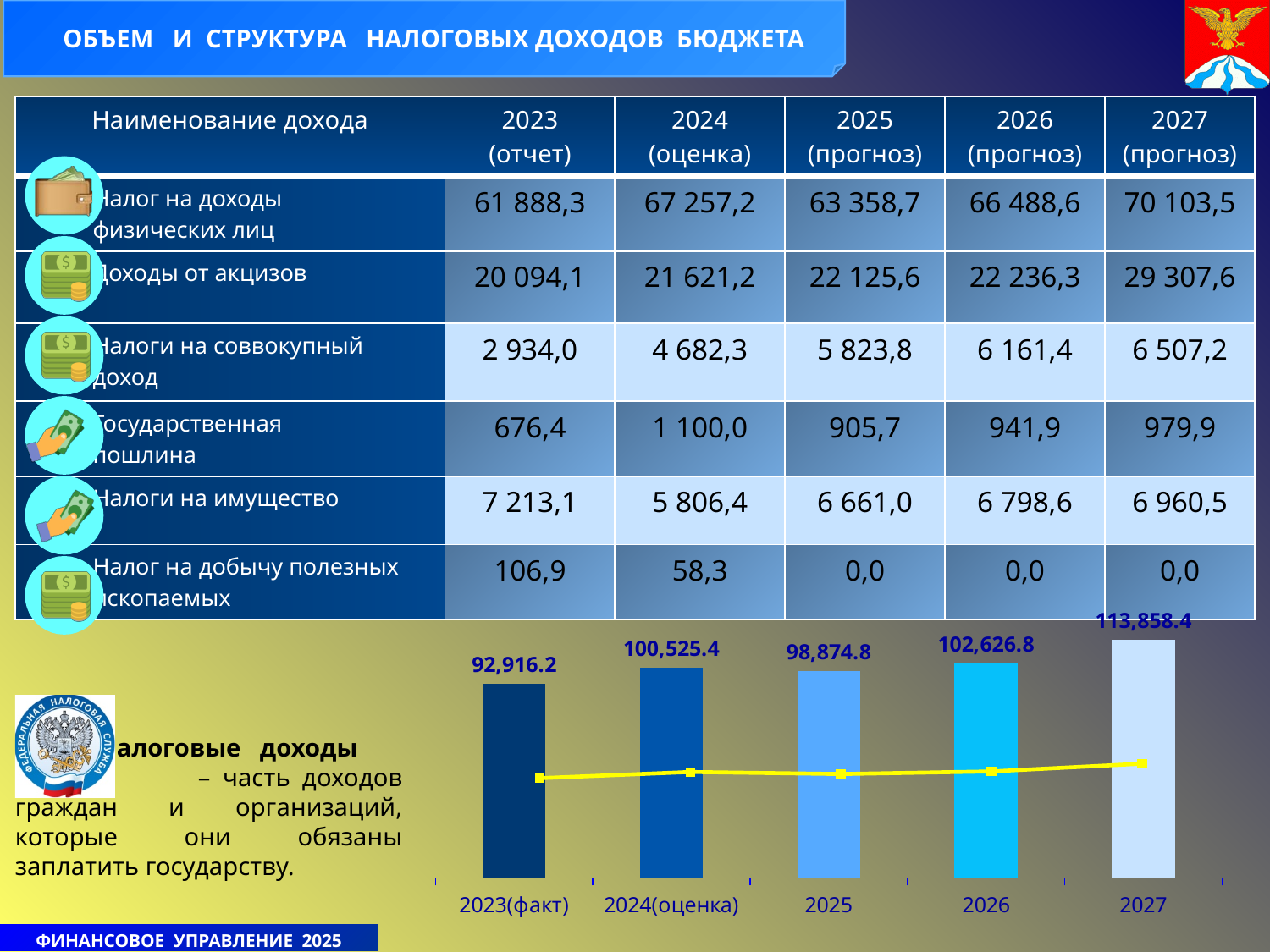
What kind of chart is shown at the bottom of the slide? Bar chart Which is larger in the bar chart, the value for 2024(оценка) or the value for 2025? 2024(оценка) What is the value shown for 2023(факт) in the bar chart? 92,916.2 What is the difference between the 2027 value and the 2023(факт) value in the bar chart? 20,942.2 How many bars are plotted in the chart? 5 What is the value shown for 2025 in the bar chart? 98,874.8 What is the value shown for 2026 in the bar chart? 102,626.8 What is the difference between the 2026 value and the 2025 value in the bar chart? 3,752.0 Which year has the lowest bar in the chart? 2023(факт) Which year has the highest bar in the chart? 2027 What is the value shown for 2027 in the bar chart? 113,858.4 What is the value shown for 2024(оценка) in the bar chart? 100,525.4